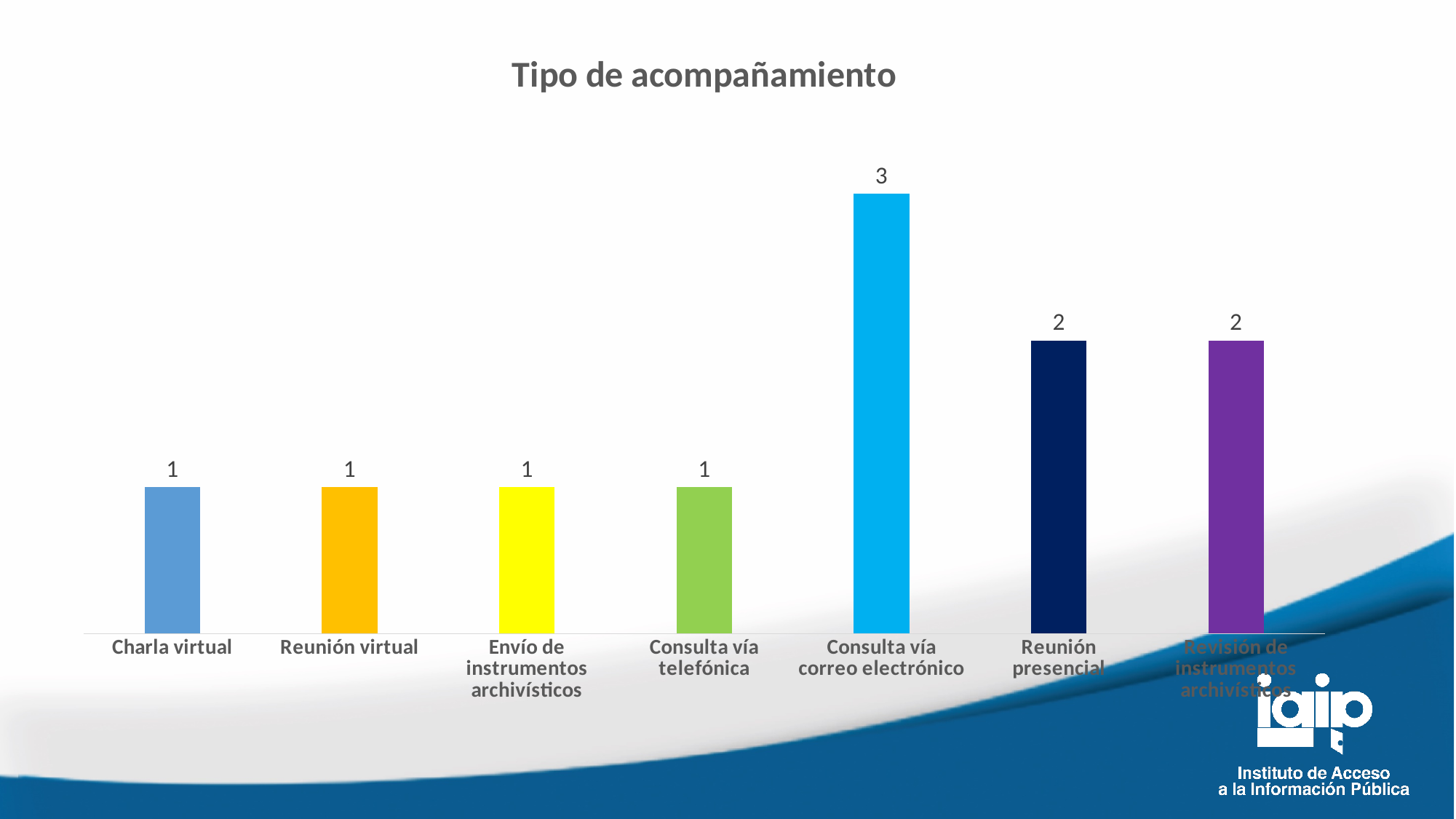
What is the value for Consulta vía correo electrónico? 3 How many categories are shown in the chart? 7 Which is larger, the value for Consulta vía correo electrónico or the value for Reunión virtual? Consulta vía correo electrónico What is the difference between the values for Reunión presencial and Consulta vía telefónica? 1 What is the title of the chart? Tipo de acompañamiento How many categories have a value of 1? 4 What is the difference between the values for Consulta vía correo electrónico and Reunión presencial? 1 What is the value for Reunión presencial? 2 What is the value for Revisión de instrumentos archivísticos? 2 Which category has the highest value? Consulta vía correo electrónico What kind of chart is shown on the slide? Bar chart What is the value for Charla virtual? 1